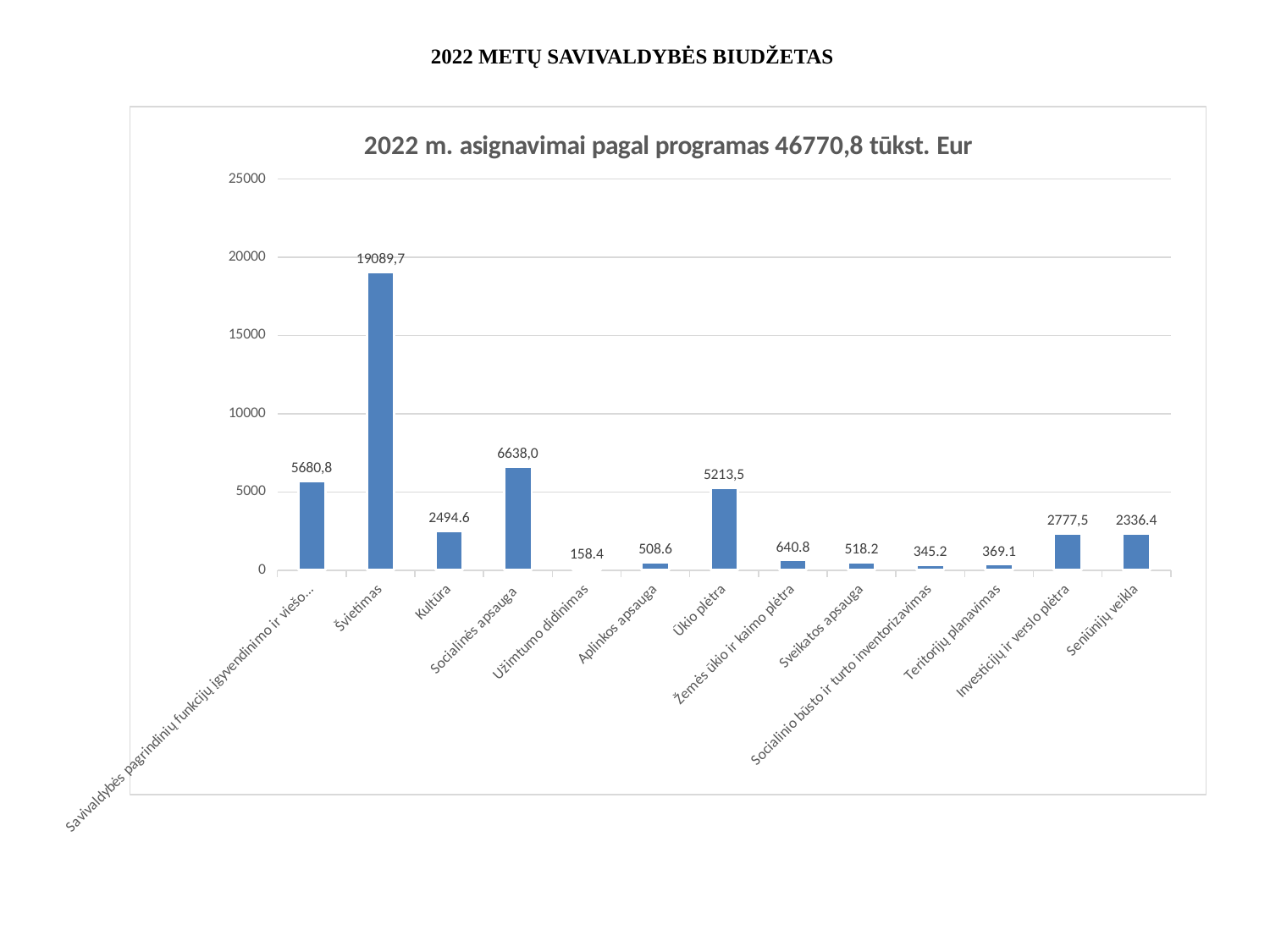
What type of chart is shown on the slide? bar chart Which category has the lowest value? Užimtumo didinimas What is the difference between the values for Žemės ūkio ir kaimo plėtra and Užimtumo didinimas? 482.4 Which category has the highest value? Švietimas What is the difference between the values for Švietimas and Socialinės apsauga? 12451,7 What is the title of the chart? 2022 m. asignavimai pagal programas 46770,8 tūkst. Eur How many categories are shown on the x axis? 13 Is the value for Kultūra greater or less than 5000? less What is the value for Švietimas? 19089,7 What is the value for Socialinės apsauga? 6638,0 What is the value for Teritorijų planavimas? 369.1 Which is larger, the value for Ūkio plėtra or the value for Socialinės apsauga? Socialinės apsauga